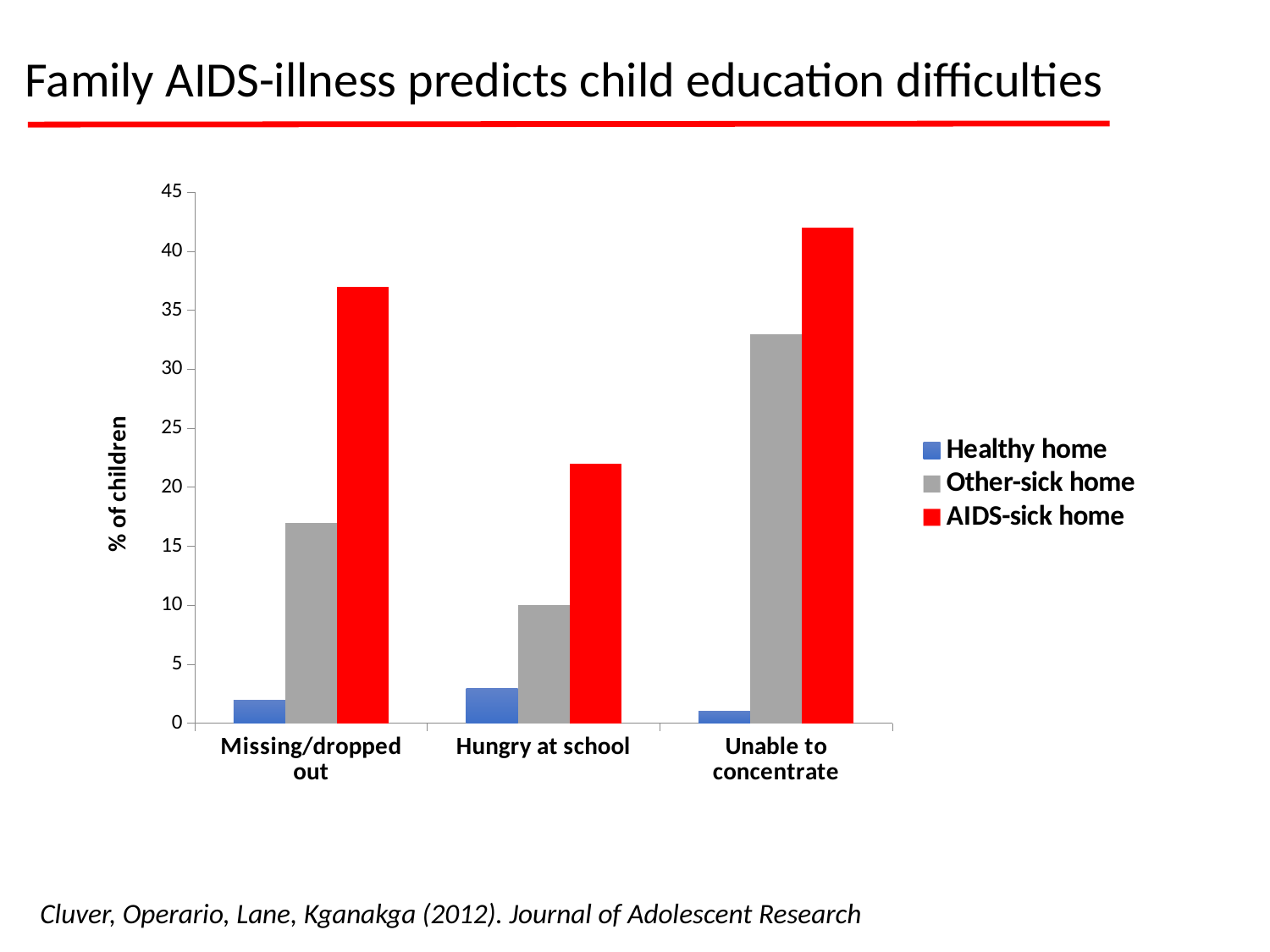
Which series has the highest value for Unable to concentrate? AIDS-sick home How many categories are shown on the x axis? 3 Is the value for Other-sick home in the Missing/dropped out category greater or less than 20? less Which colour represents the AIDS-sick home series? red Is the value for AIDS-sick home in the Unable to concentrate category greater or less than 40? greater What type of chart is shown on the slide? bar chart Which is larger for Other-sick home: Missing/dropped out or Unable to concentrate? Unable to concentrate How many series does the legend list? 3 What is the label of the y axis? % of children Which category has the highest AIDS-sick home value? Unable to concentrate Is the value for AIDS-sick home in the Hungry at school category greater or less than 20? greater Which series has the lowest value for Missing/dropped out? Healthy home